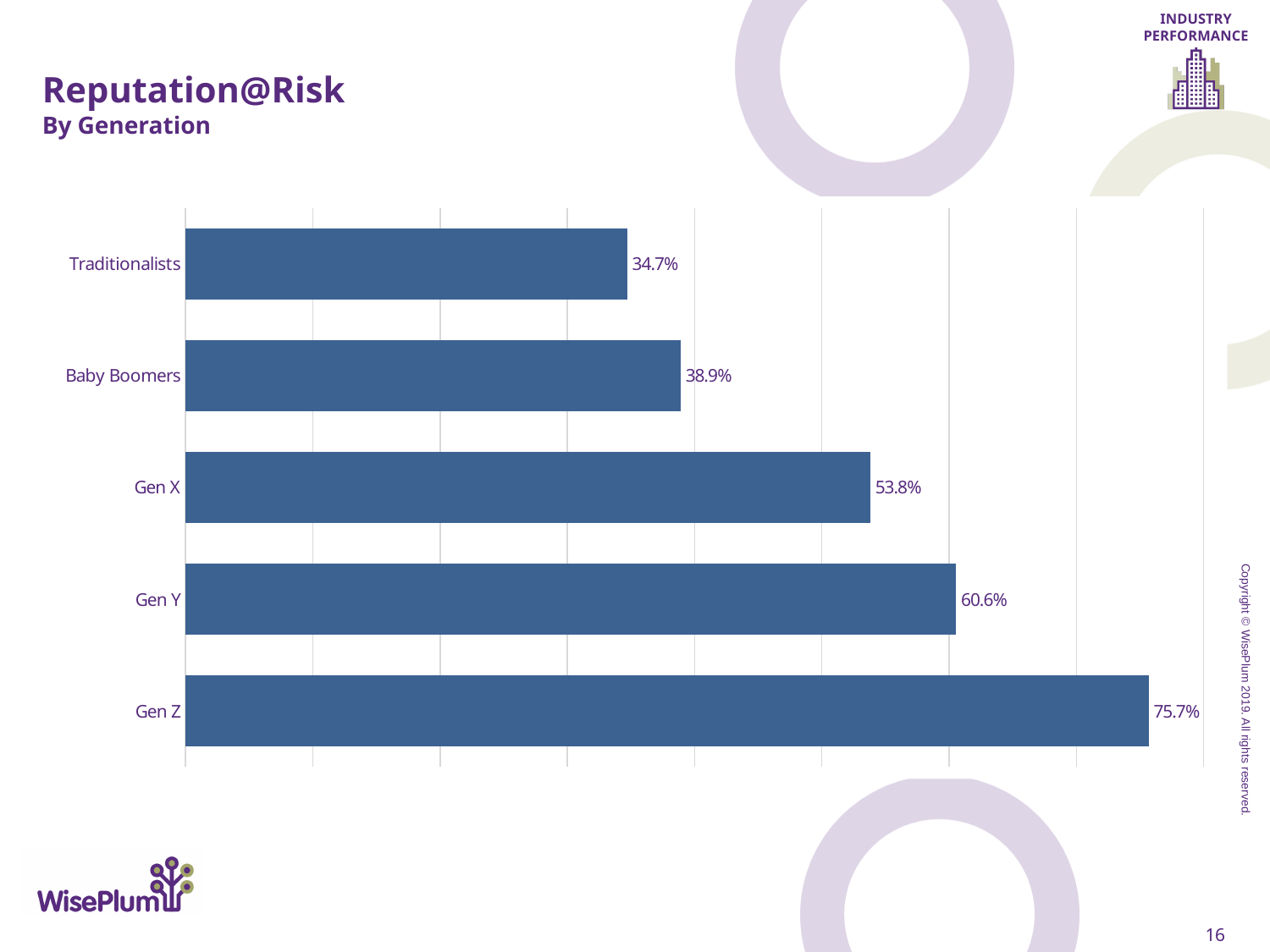
What is the value for Gen X? 53.8% What kind of chart is shown on the slide? Bar chart What is the value for Gen Z? 75.7% Which generation has the lowest value? Traditionalists Which is larger, the value for Gen X or the value for Baby Boomers? Gen X How many generations are shown in the chart? 5 What is the title of the slide containing the chart? Reputation@Risk By Generation What is the difference between the values for Baby Boomers and Traditionalists? 4.2% Which generation has the highest value? Gen Z What is the value for Baby Boomers? 38.9% What is the difference between the values for Gen Z and Gen Y? 15.1% What is the value for Traditionalists? 34.7%